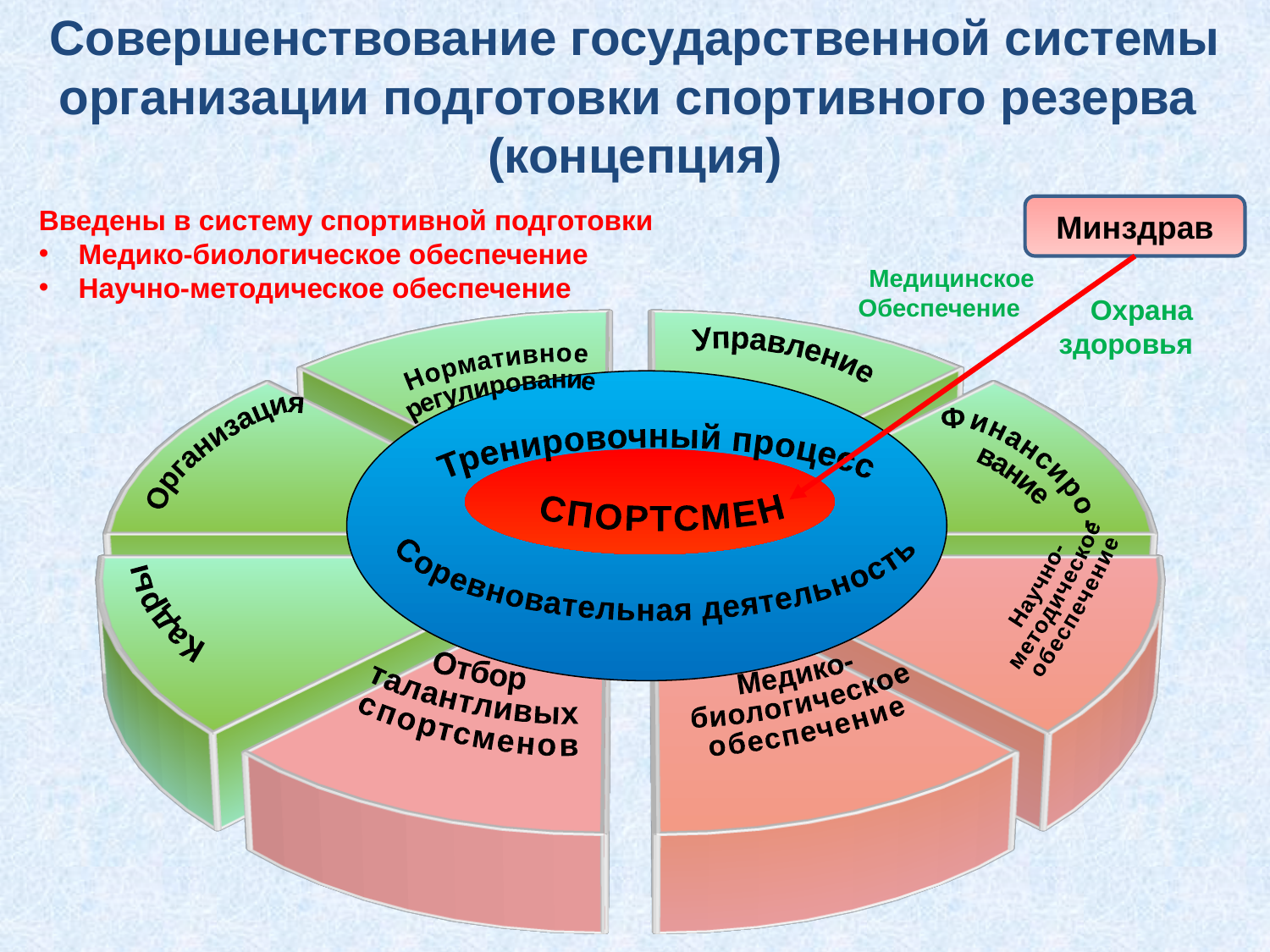
Which two segments of the outer ring are coloured pink and labelled with 'обеспечение'? Медико-биологическое обеспечение and Научно-методическое обеспечение How many segments of the outer ring are coloured pink/red rather than green? 3 What kind of chart-like shape is used for the diagram? pie chart How many labelled segments make up the outer ring of the diagram? 8 What label is written in the red centre of the diagram? СПОРТСМЕН What text is in the box that the red arrow starts from? Минздрав